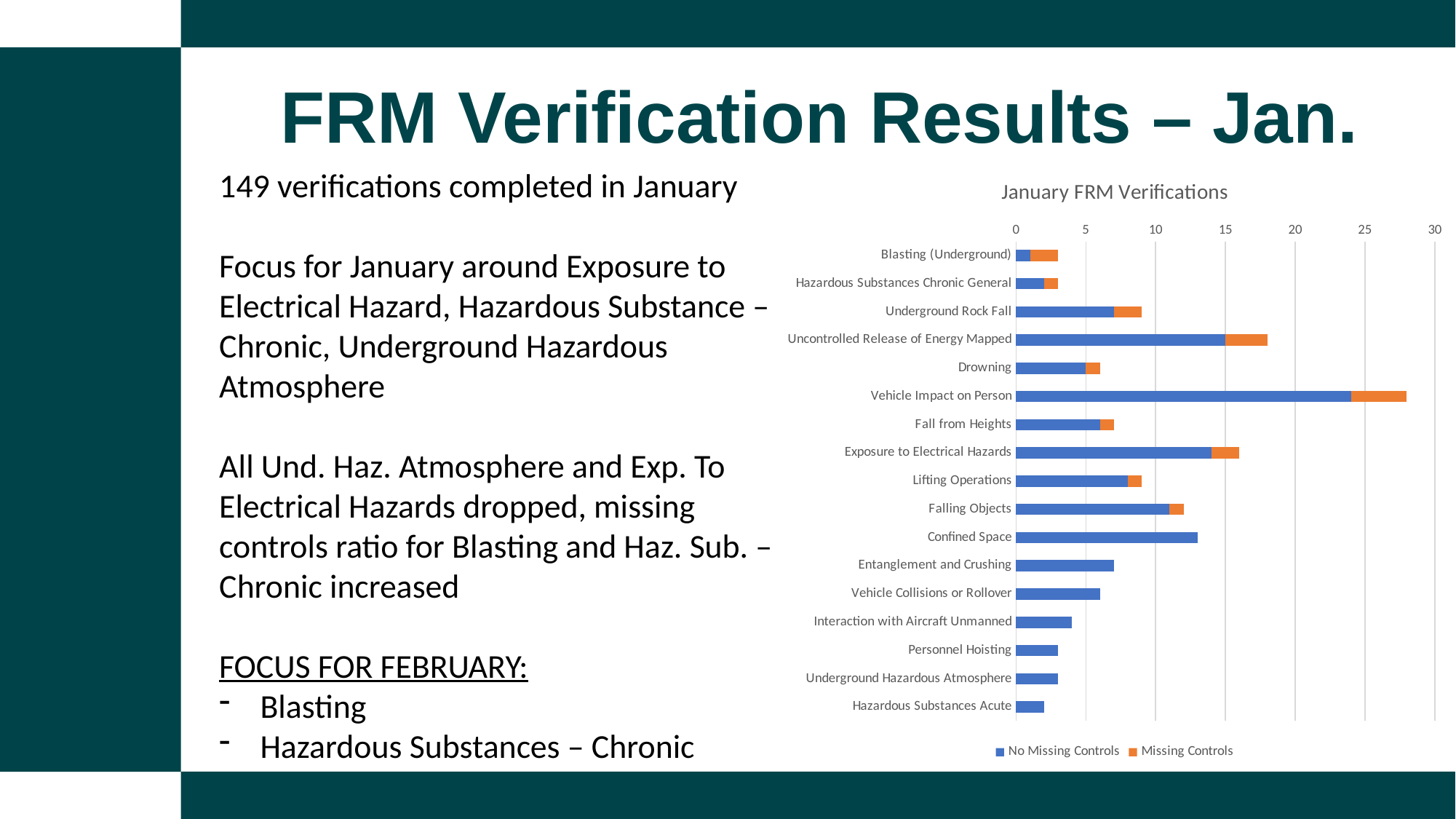
Which category has the shortest total bar? Hazardous Substances Acute What kind of chart is shown on the slide? bar chart What is the title of the chart? January FRM Verifications Which category has the longest total bar? Vehicle Impact on Person Which has the longer total bar, Confined Space or Entanglement and Crushing? Confined Space Is the total bar for Interaction with Aircraft Unmanned greater or less than 5? less Which has the longer total bar, Uncontrolled Release of Energy Mapped or Underground Rock Fall? Uncontrolled Release of Energy Mapped What are the two series named in the chart legend? No Missing Controls and Missing Controls How many series does the chart legend list? 2 How many categories are plotted on the chart? 17 Is the total bar for Confined Space greater or less than 10? greater Is the total bar for Vehicle Impact on Person greater or less than 25? greater